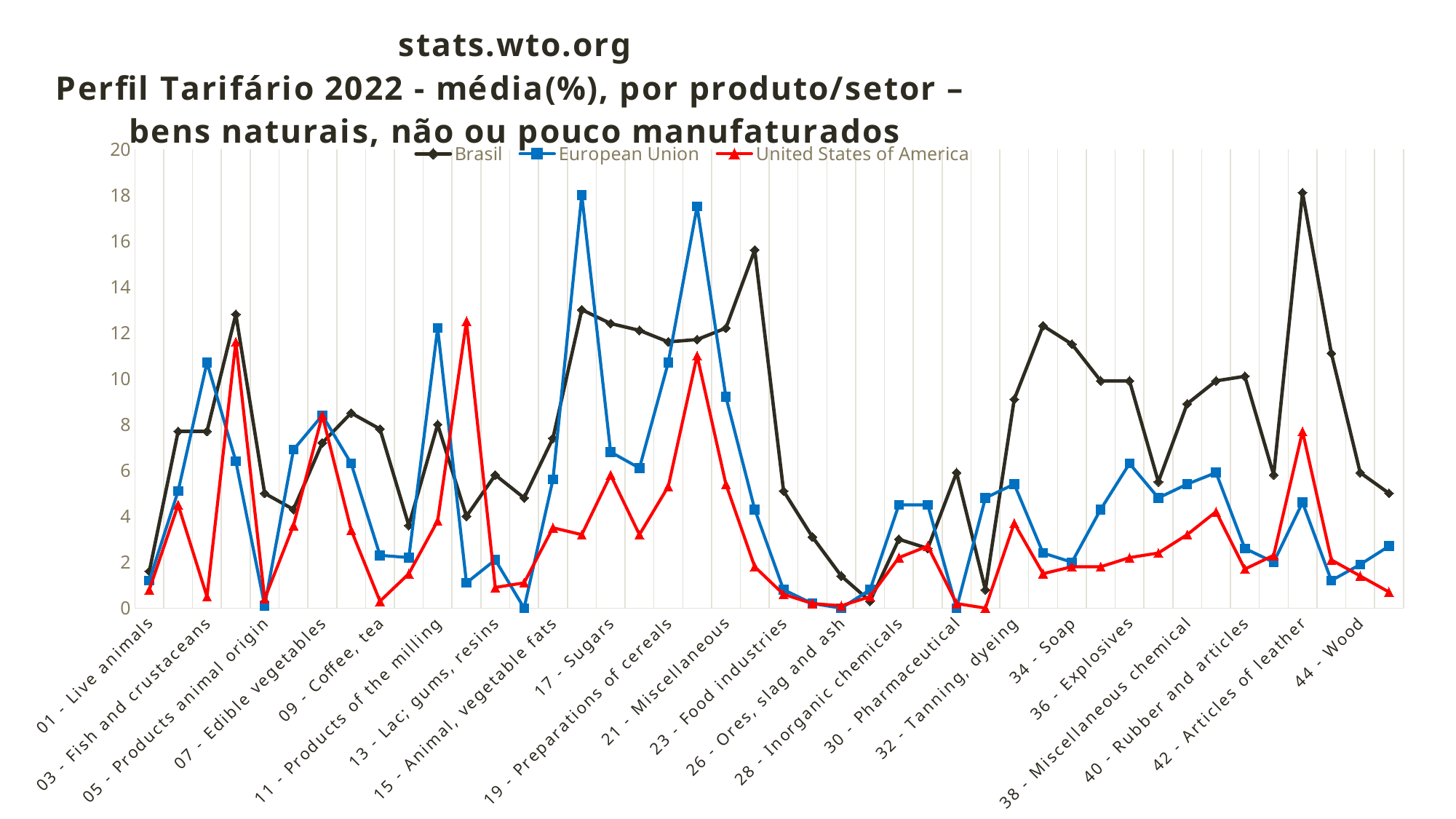
Is the Brasil value for 42 - Articles of leather greater or less than 16? greater For 44 - Wood, which series has the larger value, Brasil or United States of America? Brasil How many series does the legend list? 3 For 03 - Fish and crustaceans, which series has the larger value, Brasil or European Union? European Union For which category does the Brasil series reach its highest value? 42 - Articles of leather Is the Brasil value for 09 - Coffee, tea greater or less than 6? greater Is the Brasil value for 34 - Soap greater or less than 10? greater What kind of chart is shown on the slide? line chart Which three series are listed in the legend? Brasil, European Union, United States of America For 05 - Products animal origin, which series has the larger value, Brasil or European Union? Brasil